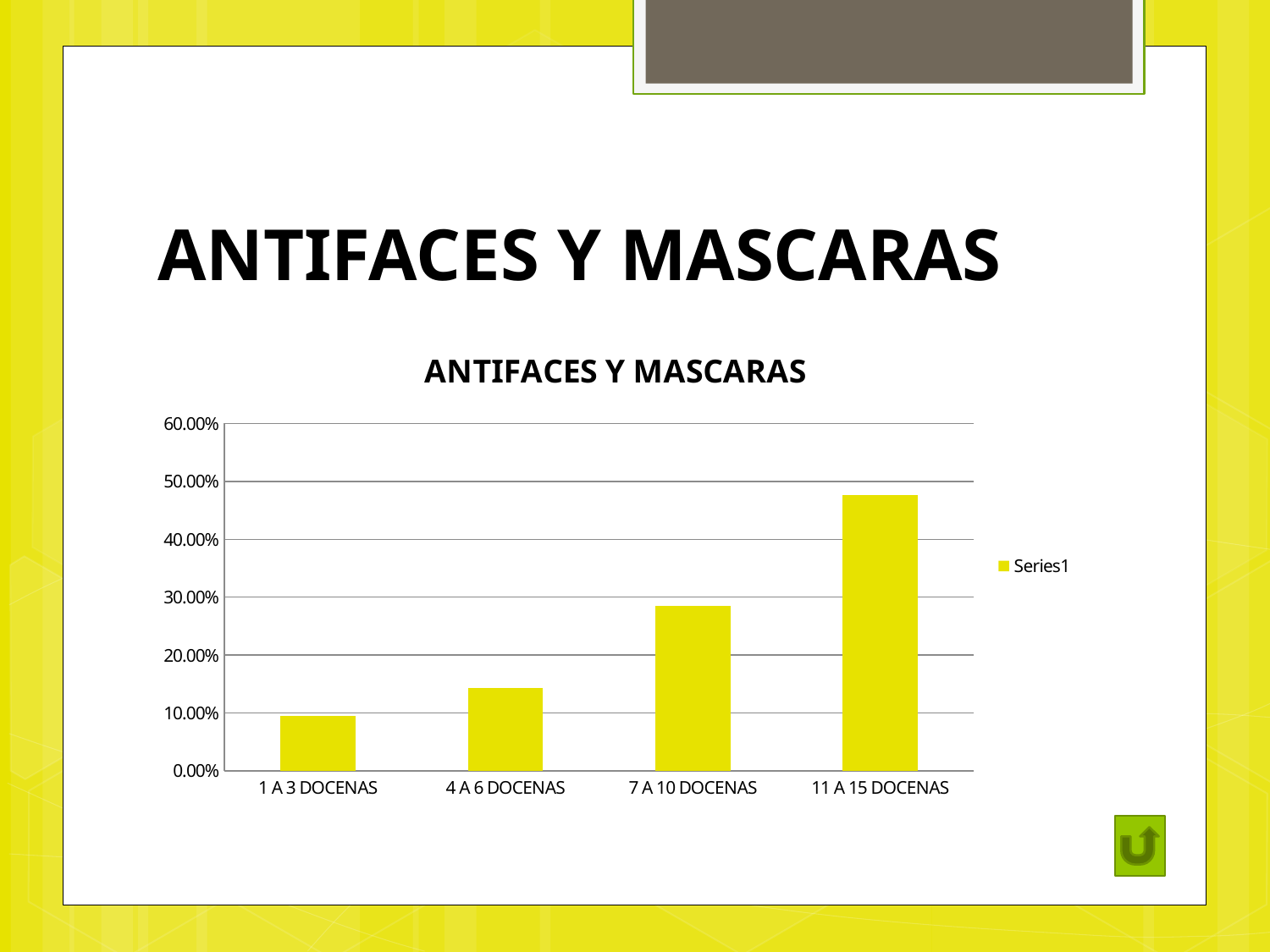
What is the title of the chart? ANTIFACES Y MASCARAS Do the values rise or fall from left to right along the x axis? Rise Which category has the lowest value? 1 A 3 DOCENAS Which category has the highest value? 11 A 15 DOCENAS What type of chart is shown on the slide? Bar chart What is the name of the series shown in the legend? Series1 Is the value for 1 A 3 DOCENAS greater or less than 10.00%? less Which is larger, the value for 4 A 6 DOCENAS or the value for 7 A 10 DOCENAS? 7 A 10 DOCENAS How many series does the legend list? 1 Is the value for 11 A 15 DOCENAS greater or less than 40.00%? greater Is the value for 7 A 10 DOCENAS greater or less than 20.00%? greater How many categories are shown on the x axis of the chart? 4